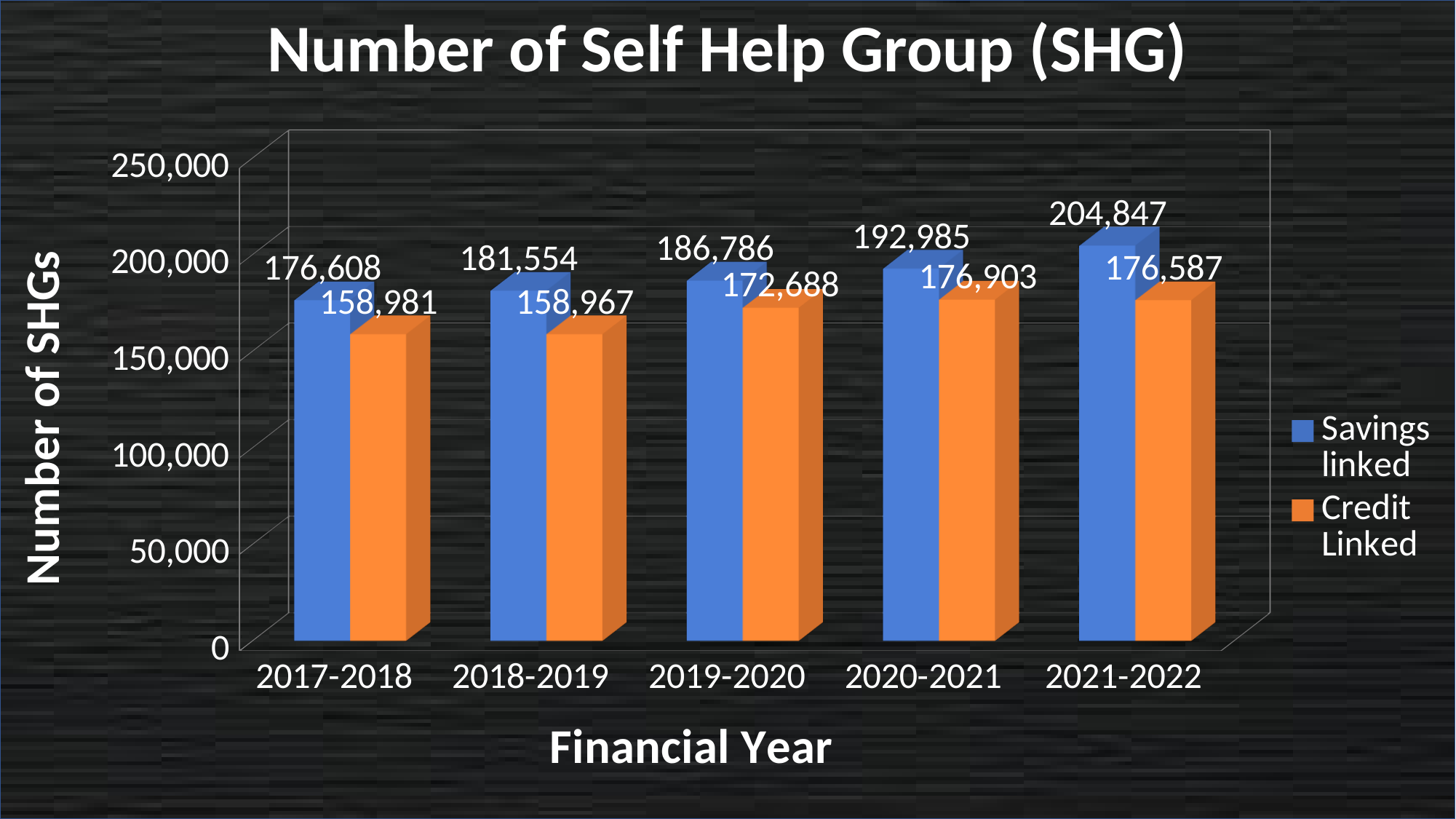
How many series does the legend list? 2 What is the Savings linked value for 2019-2020? 186,786 What type of chart is shown on the slide? Bar chart Which financial year has the highest Savings linked value? 2021-2022 What is the title of the chart? Number of Self Help Group (SHG) Do the Savings linked values rise or fall from 2017-2018 to 2021-2022? Rise What is the Credit Linked value for 2017-2018? 158,981 Which is larger for 2020-2021, the Savings linked value or the Credit Linked value? Savings linked How many financial years are shown on the x axis? 5 What is the Savings linked value for 2021-2022? 204,847 Which financial year has the lowest Savings linked value? 2017-2018 What is the difference between the Savings linked and Credit Linked values for 2021-2022? 28,260